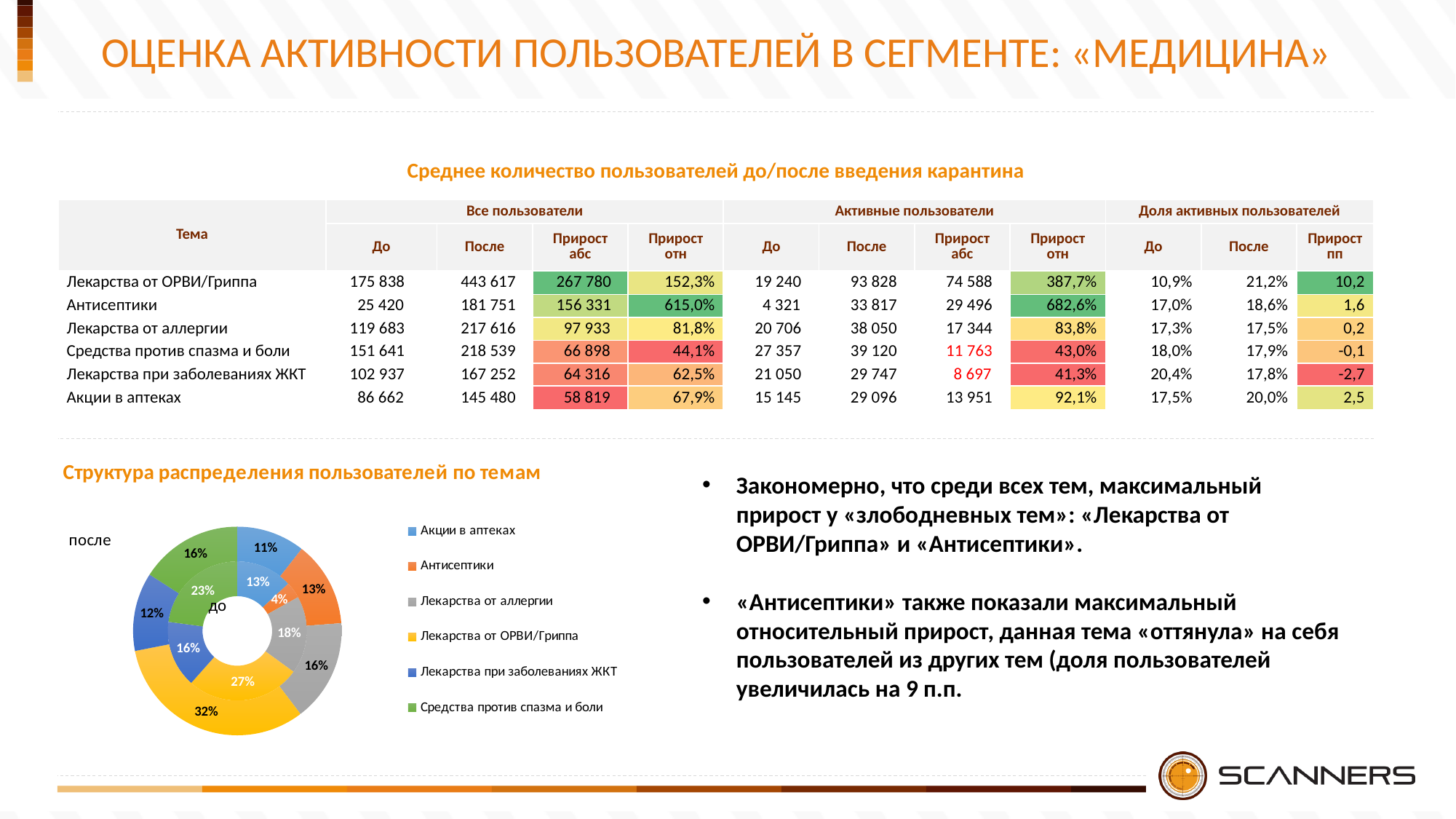
In the doughnut chart, what colour represents «Средства против спазма и боли»? Green In the doughnut chart, what is the share of «Лекарства от ОРВИ/Гриппа» in the inner ring («до»)? 27% What kind of chart is shown under the heading «Структура распределения пользователей по темам»? Doughnut chart In the doughnut chart, which is larger in the outer ring («после»): the share of «Акции в аптеках» or the share of «Лекарства от аллергии»? Лекарства от аллергии In the doughnut chart, what is the share of «Лекарства при заболеваниях ЖКТ» in the outer ring («после»)? 12% In the doughnut chart, what is the share of «Антисептики» in the outer ring («после»)? 13% In the doughnut chart, what is the share of «Антисептики» in the inner ring («до»)? 4% In the doughnut chart, which category has the largest share in the outer ring («после»)? Лекарства от ОРВИ/Гриппа In the doughnut chart, how many categories does the legend list? 6 In the doughnut chart, by how many percentage points did the share of «Антисептики» change from the inner ring («до», 4%) to the outer ring («после», 13%)? 9 In the doughnut chart, what is the share of «Лекарства от ОРВИ/Гриппа» in the outer ring («после»)? 32% In the doughnut chart, which category has the smallest share in the inner ring («до»)? Антисептики